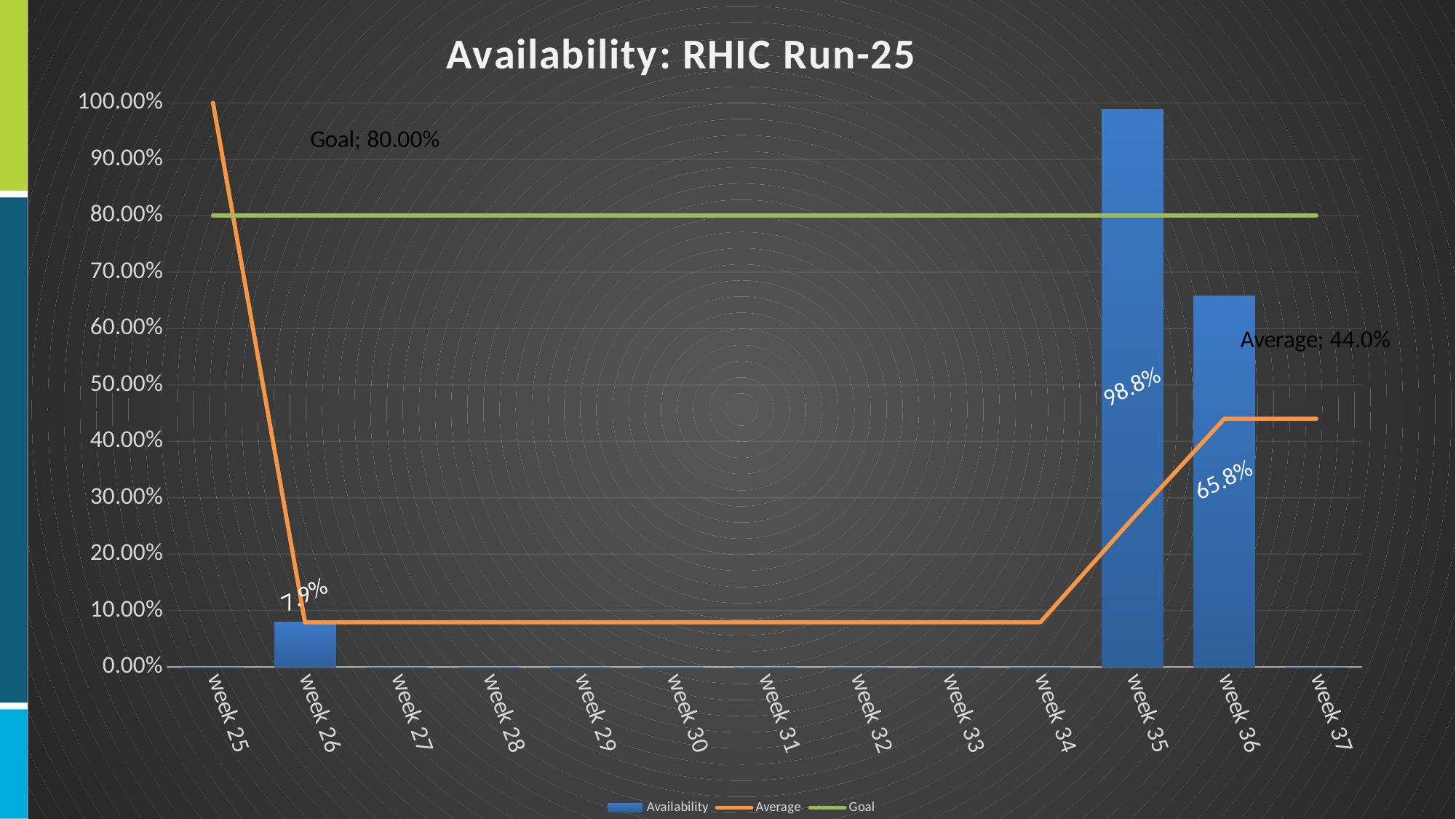
What is the final Average value labelled on the chart? 44.0% What is the availability value for week 35? 98.8% Which is larger, the availability for week 26 or week 36? week 36 How many series does the legend list? 3 What is the title of the chart? Availability: RHIC Run-25 What value does the Goal line show? 80.00% What is the availability value for week 36? 65.8% Is the availability for week 36 greater or less than the 80.00% goal line? less What is the availability value for week 26? 7.9% What is the difference between the availability for week 35 and week 36? 33.0% Which week has the highest availability bar? week 35 How many weeks are shown on the x axis? 13